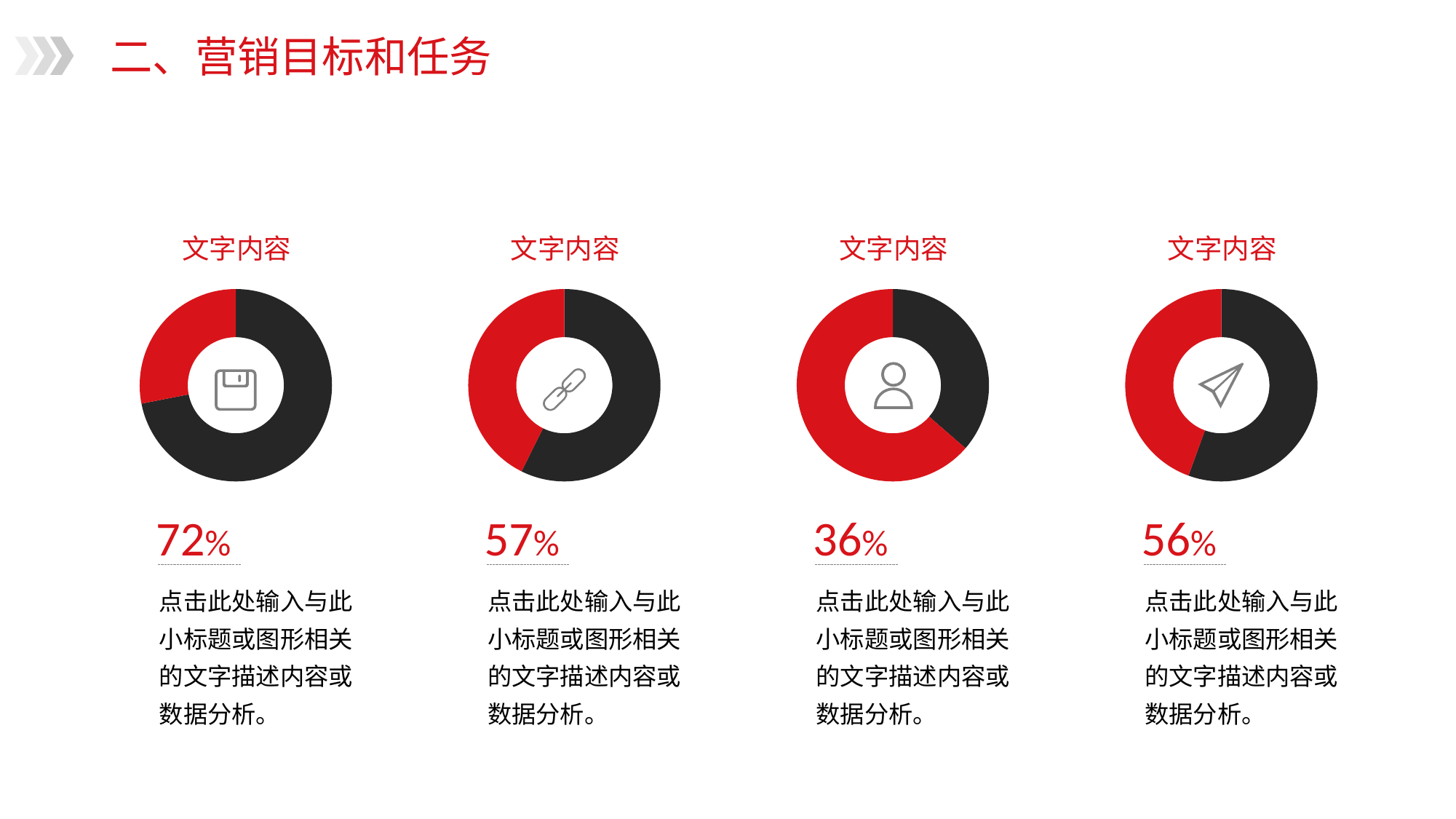
Which is larger: the percentage printed under the second chart or the percentage printed under the fourth chart? The second chart (57%) What kind of chart is used for each of the four figures on the slide? Donut (pie) chart Which of the four donut charts has the lowest printed percentage? The third chart, 36% How many donut charts are shown on the slide? 4 What is the difference between the percentages printed under the first and fourth charts? 16 percentage points What is the difference between the percentage printed under the first chart and the percentage printed under the third chart? 36 percentage points What percentage is printed below the fourth (rightmost) donut chart? 56% What two colours are used for the segments of each donut chart? Red and black Which of the four donut charts has the highest printed percentage? The first (leftmost) chart, 72% What percentage is printed below the third donut chart from the left? 36% What percentage is printed below the second donut chart from the left? 57% What percentage is printed below the first (leftmost) donut chart? 72%